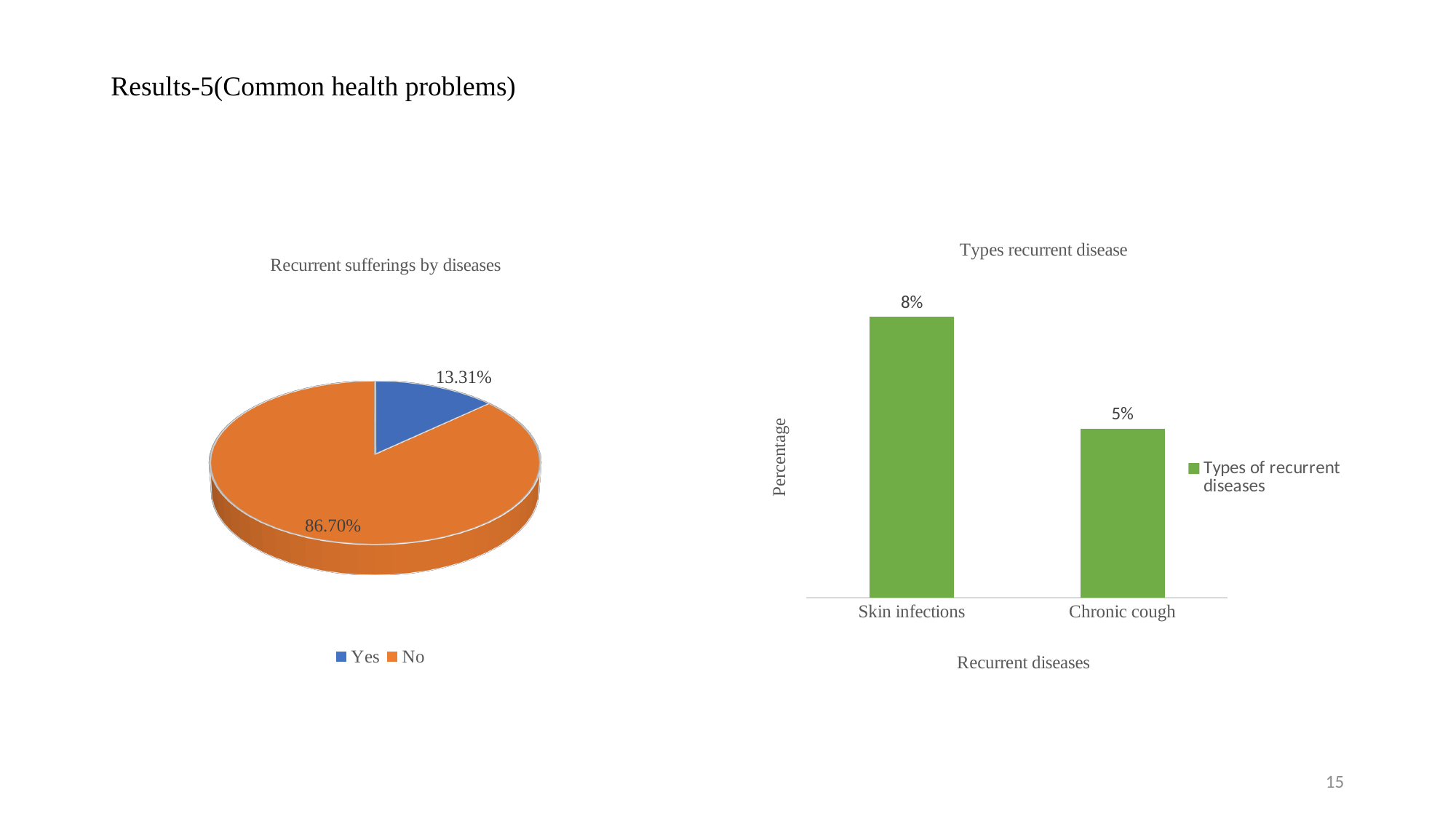
In the 'Recurrent sufferings by diseases' pie chart, how many slices are there? 2 In the 'Recurrent sufferings by diseases' pie chart, which slice is larger, 'Yes' or 'No'? No In the 'Types recurrent disease' chart, what is the difference between 'Skin infections' and 'Chronic cough'? 3% In the 'Recurrent sufferings by diseases' pie chart, what percentage is shown for 'No'? 86.70% In the 'Types recurrent disease' chart, what is the label on the y axis? Percentage What kind of chart is 'Recurrent sufferings by diseases'? Pie chart In the 'Types recurrent disease' chart, which category has the highest value? Skin infections In the 'Types recurrent disease' chart, what is the value for 'Chronic cough'? 5% In the 'Recurrent sufferings by diseases' pie chart, what percentage is shown for 'Yes'? 13.31% In the 'Recurrent sufferings by diseases' pie chart, what is the difference between the 'No' and 'Yes' percentages? 73.39% What kind of chart is 'Types recurrent disease'? Bar chart In the 'Types recurrent disease' chart, what is the value for 'Skin infections'? 8%